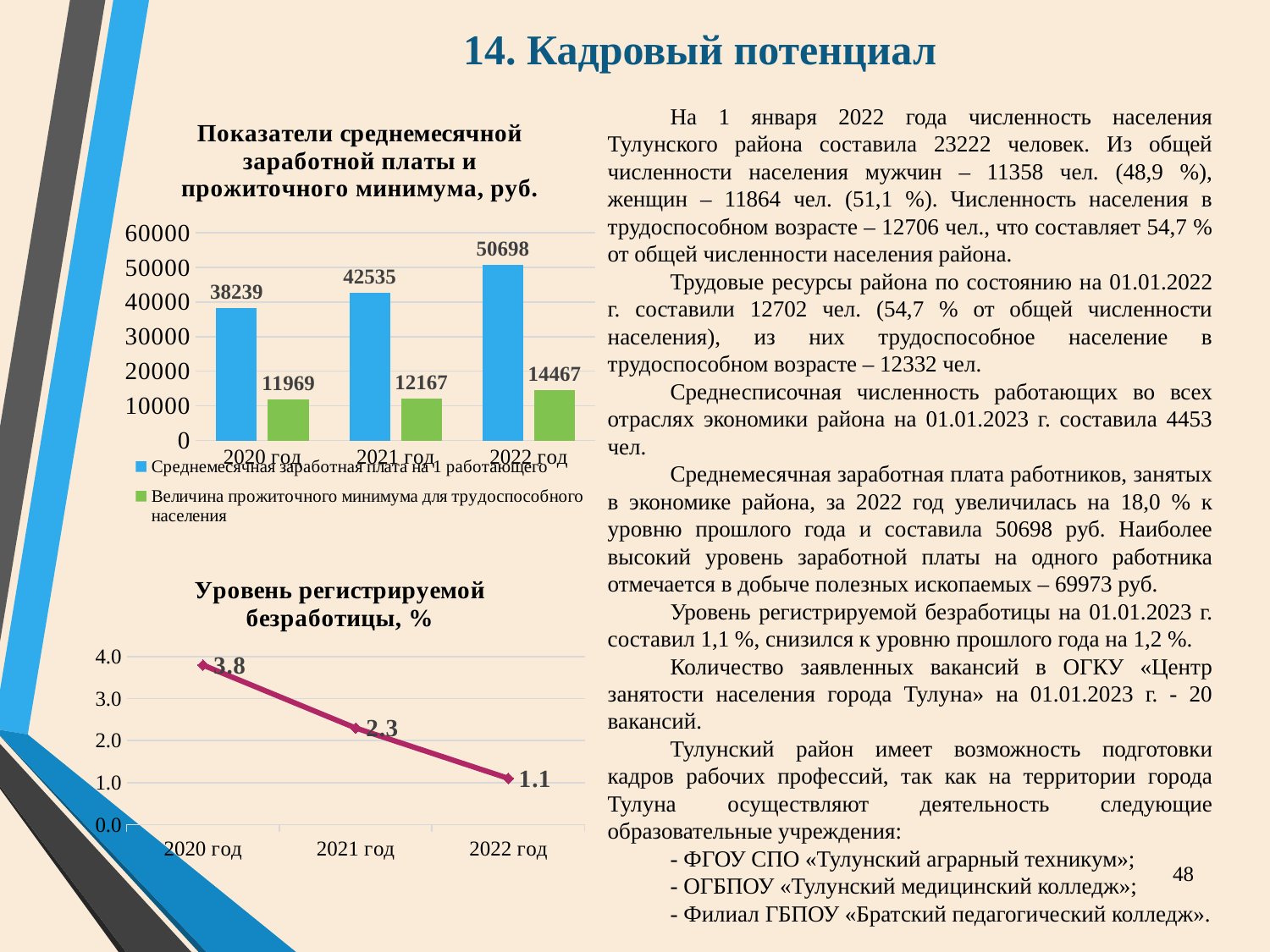
In the chart 'Показатели среднемесячной заработной платы и прожиточного минимума, руб.', what is the difference between the average monthly salary in 2022 год and in 2021 год? 8163 In the chart 'Уровень регистрируемой безработицы, %', what is the value for 2021 год? 2.3 In the chart 'Показатели среднемесячной заработной платы и прожиточного минимума, руб.', which year has the highest average monthly salary? 2022 год In the chart 'Уровень регистрируемой безработицы, %', which year has the lowest value? 2022 год In the chart 'Уровень регистрируемой безработицы, %', do the values rise or fall from 2020 год to 2022 год? fall How many years are shown on the x axis of the chart 'Уровень регистрируемой безработицы, %'? 3 In the chart 'Показатели среднемесячной заработной платы и прожиточного минимума, руб.', how many series does the legend list? 2 In the chart 'Уровень регистрируемой безработицы, %', what is the difference between the values for 2020 год and 2022 год? 2.7 What kind of chart is 'Показатели среднемесячной заработной платы и прожиточного минимума, руб.'? bar chart In the chart 'Показатели среднемесячной заработной платы и прожиточного минимума, руб.', what is the average monthly salary (Среднемесячная заработная плата на 1 работающего) for 2022 год? 50698 In the chart 'Показатели среднемесячной заработной платы и прожиточного минимума, руб.', what is the value of the subsistence minimum (Величина прожиточного минимума) for 2020 год? 11969 In the chart 'Показатели среднемесячной заработной платы и прожиточного минимума, руб.', is the average monthly salary for 2020 год greater or less than 40000? less